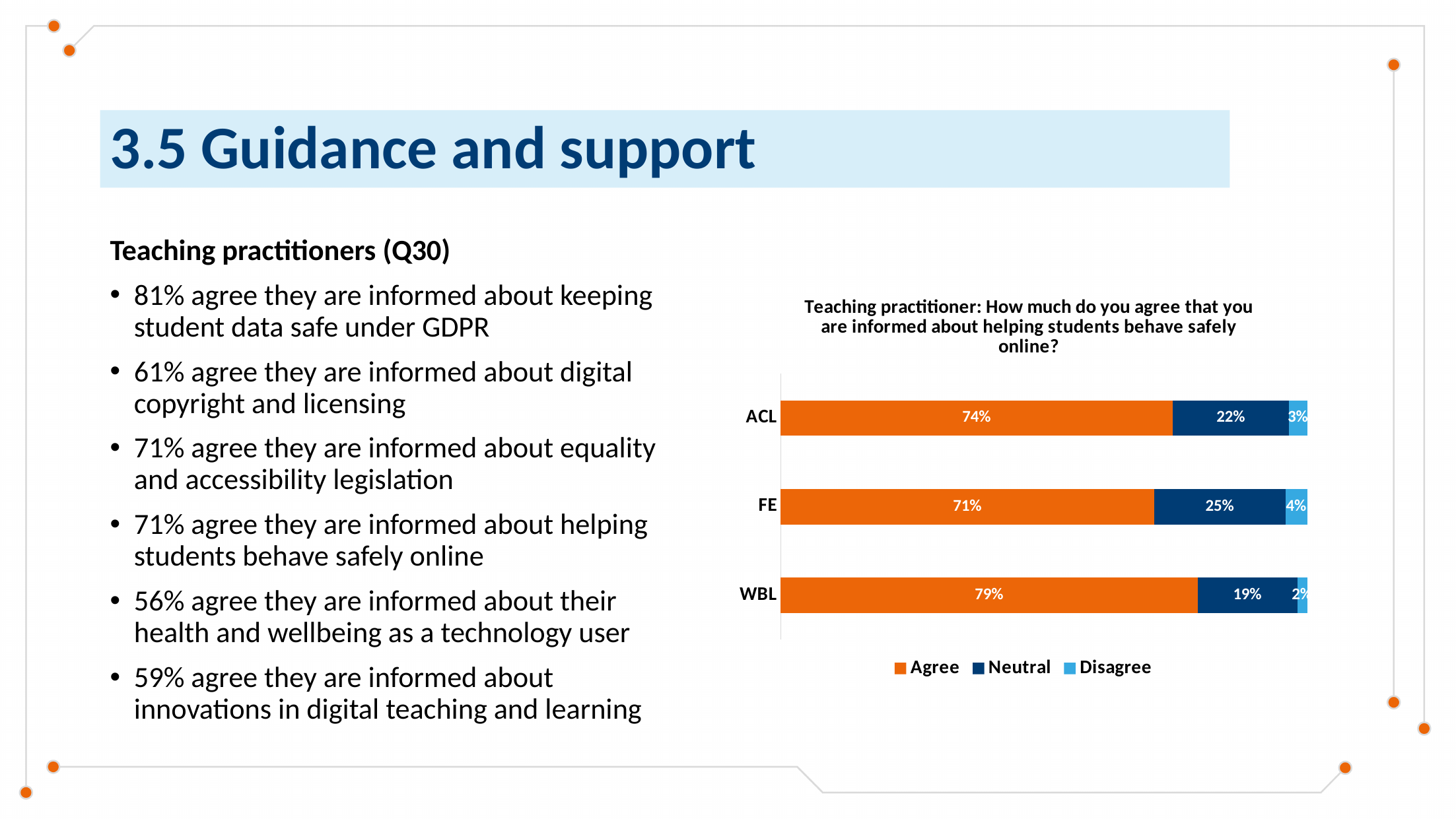
What kind of chart is shown on the slide? Stacked bar chart How many series does the legend list? 3 What is the difference between the Agree percentages for WBL and FE? 8% What percentage of ACL teaching practitioners agree they are informed about helping students behave safely online? 74% What is the Neutral value for FE in the chart? 25% What is the Disagree value for WBL in the chart? 2% Which has a larger Neutral percentage, ACL or WBL? ACL How many categories are shown on the chart? 3 Which colour represents the Agree series in the chart? Orange Which category has the highest Agree percentage? WBL Which category has the lowest Agree percentage? FE What is the total of the ACL bar (Agree + Neutral + Disagree)? 99%